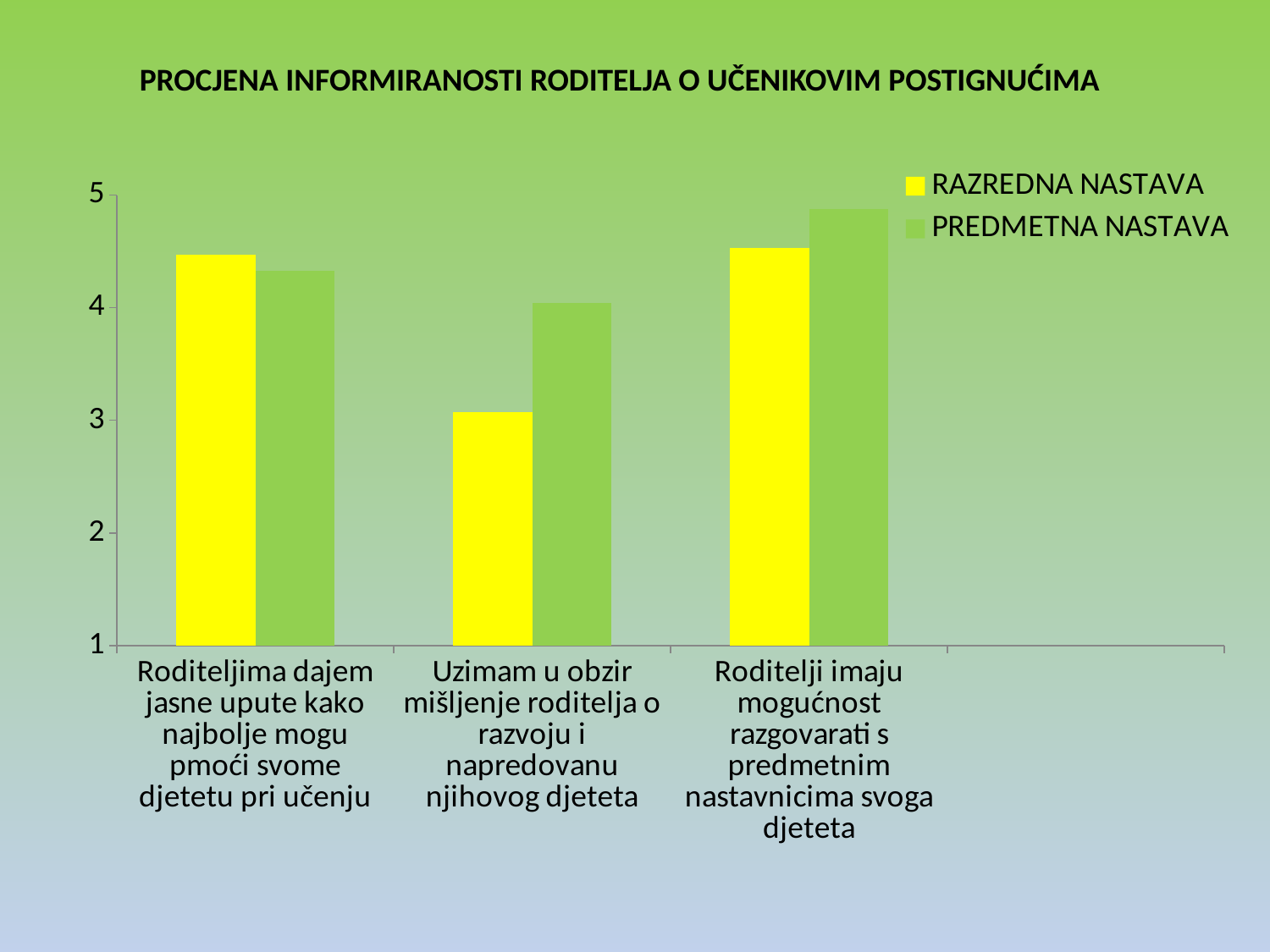
Which series is shown in yellow? RAZREDNA NASTAVA How many series does the legend list? 2 Which category has the highest value for PREDMETNA NASTAVA? Roditelji imaju mogućnost razgovarati s predmetnim nastavnicima svoga djeteta For the category 'Uzimam u obzir mišljenje roditelja o razvoju i napredovanu njihovog djeteta', which series has the larger value, RAZREDNA NASTAVA or PREDMETNA NASTAVA? PREDMETNA NASTAVA What kind of chart is shown on the slide? bar chart What is the title of the chart? PROCJENA INFORMIRANOSTI RODITELJA O UČENIKOVIM POSTIGNUĆIMA Is the RAZREDNA NASTAVA value for 'Roditeljima dajem jasne upute kako najbolje mogu pmoći svome djetetu pri učenju' greater or less than 4? greater Is the RAZREDNA NASTAVA value for 'Uzimam u obzir mišljenje roditelja o razvoju i napredovanu njihovog djeteta' greater or less than 4? less For the category 'Roditelji imaju mogućnost razgovarati s predmetnim nastavnicima svoga djeteta', which series has the larger value, RAZREDNA NASTAVA or PREDMETNA NASTAVA? PREDMETNA NASTAVA Is the PREDMETNA NASTAVA value for 'Roditelji imaju mogućnost razgovarati s predmetnim nastavnicima svoga djeteta' greater or less than 4? greater Which category has the lowest value for RAZREDNA NASTAVA? Uzimam u obzir mišljenje roditelja o razvoju i napredovanu njihovog djeteta How many categories are shown on the x axis? 3